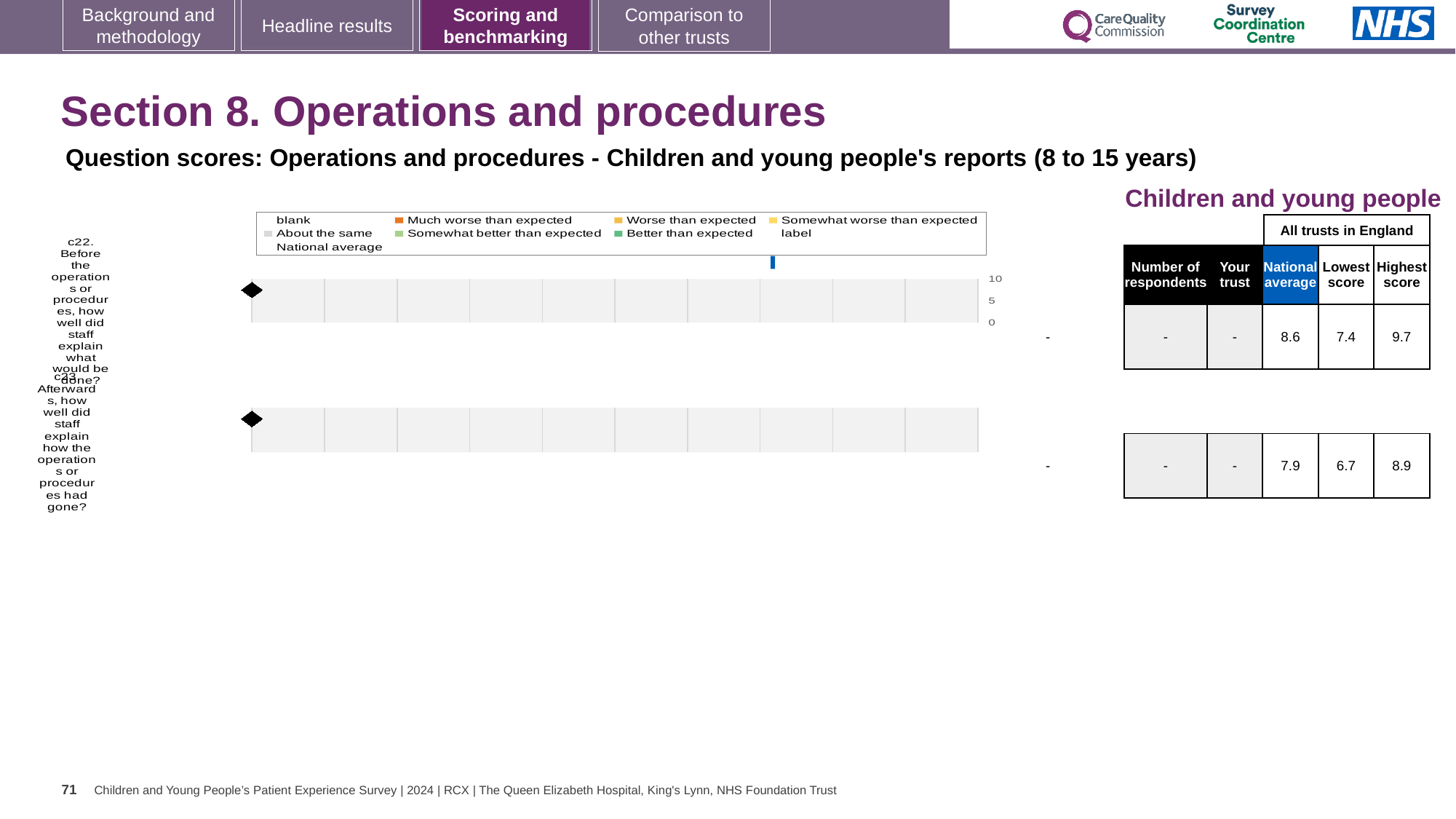
What is the national average score for question c23 (Afterwards, how well did staff explain how the operations or procedures had gone?)? 7.9 What is the national average score for question c22 (Before the operations or procedures, how well did staff explain what would be done?)? 8.6 Which question has the higher national average score, c22 or c23? c22 What is the highest score among all trusts in England for question c23? 8.9 What kind of chart is shown on the slide? bar chart What is the maximum value shown on the chart's score axis? 10 What is shown as the trust's score for question c22? - What is the difference between the highest and lowest scores for question c22? 2.3 What is the lowest score among all trusts in England for question c22? 7.4 How many questions (categories) are plotted on the chart? 2 What is the highest score among all trusts in England for question c22? 9.7 What is the lowest score among all trusts in England for question c23? 6.7